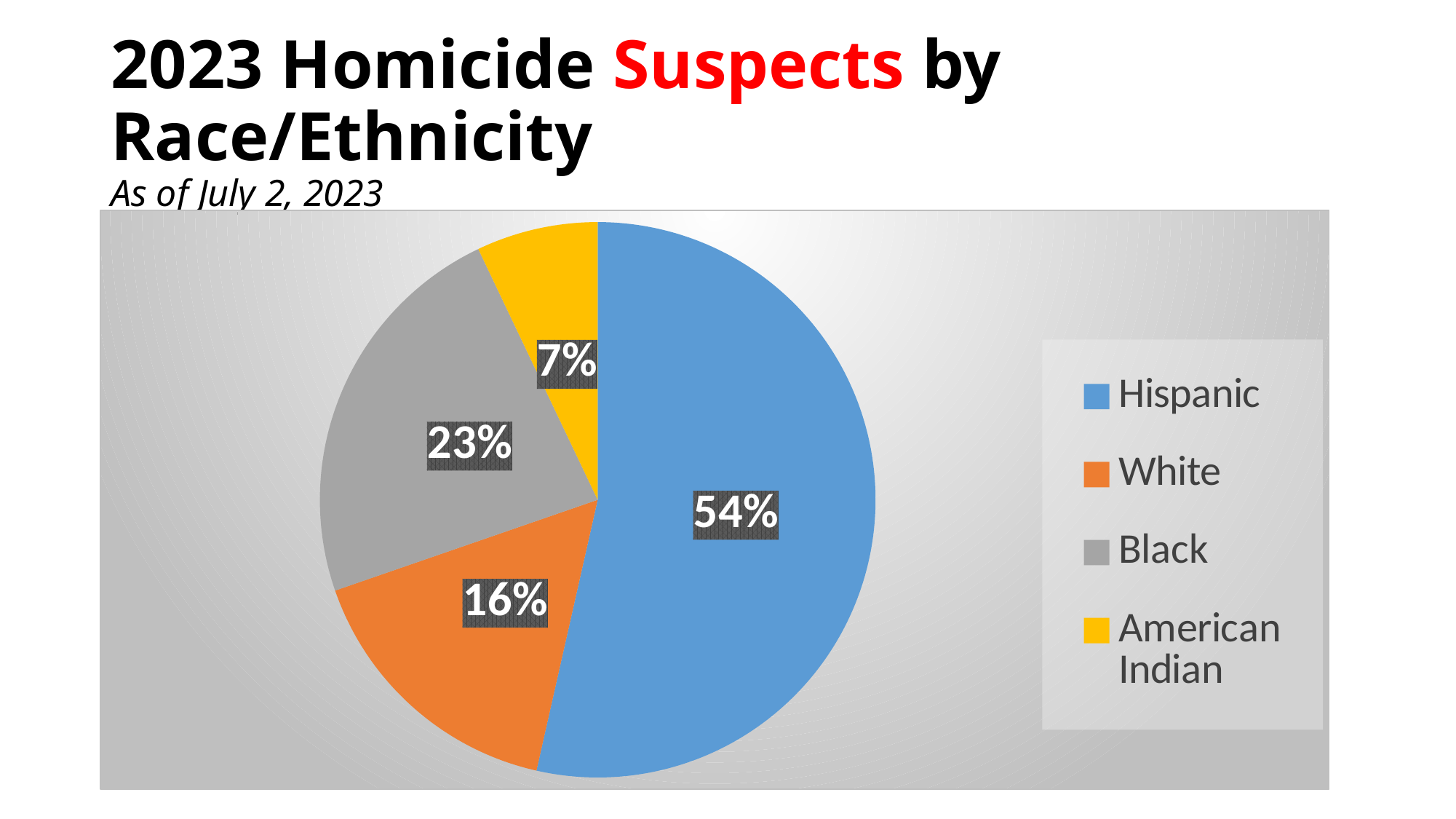
What percentage of 2023 homicide suspects are American Indian? 7% What percentage of 2023 homicide suspects are White? 16% What kind of chart is shown on the slide? pie chart What percentage of 2023 homicide suspects are Black? 23% What colour is the slice for American Indian? yellow Which race/ethnicity has the smallest share of 2023 homicide suspects? American Indian Which race/ethnicity has the largest share of 2023 homicide suspects? Hispanic What is the difference in percentage points between the Hispanic and Black shares? 31 What percentage of 2023 homicide suspects are Hispanic? 54% How many race/ethnicity categories does the pie chart show? 4 Which is larger, the share for White or the share for Black? Black What date is the data current as of, according to the subtitle? July 2, 2023